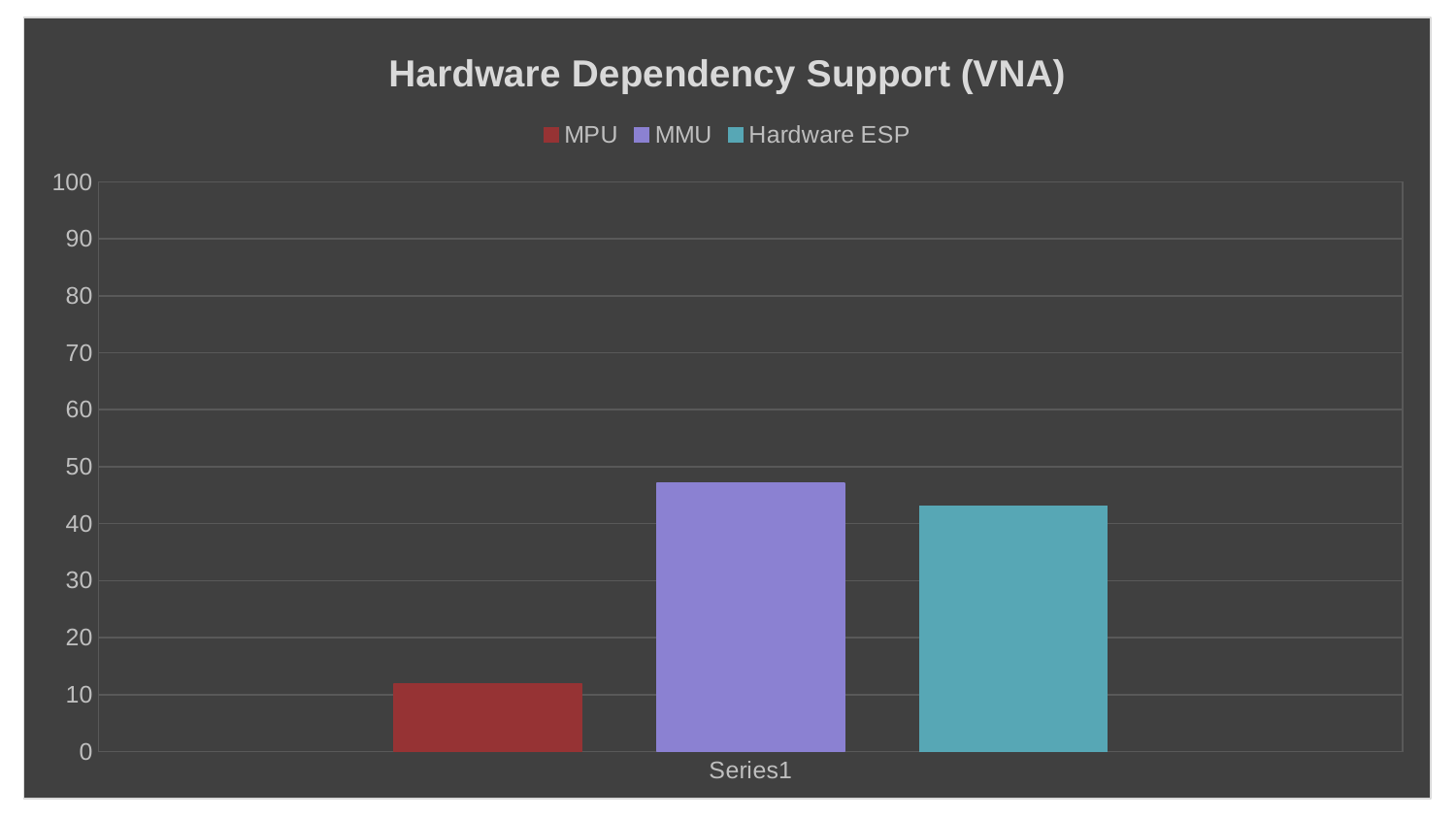
How many categories are shown on the x axis? 1 Which is larger, the value for MMU or the value for Hardware ESP? MMU Is the value for MPU greater or less than 20? less Is the value for Hardware ESP greater or less than 50? less What kind of chart is shown on the slide? bar chart What colour is the bar for Hardware ESP? teal Is the value for MMU greater or less than 40? greater What is the title of the chart? Hardware Dependency Support (VNA) Which series has the highest bar? MMU Which series has the lowest bar? MPU Which is larger, the value for MPU or the value for Hardware ESP? Hardware ESP How many series does the legend list? 3